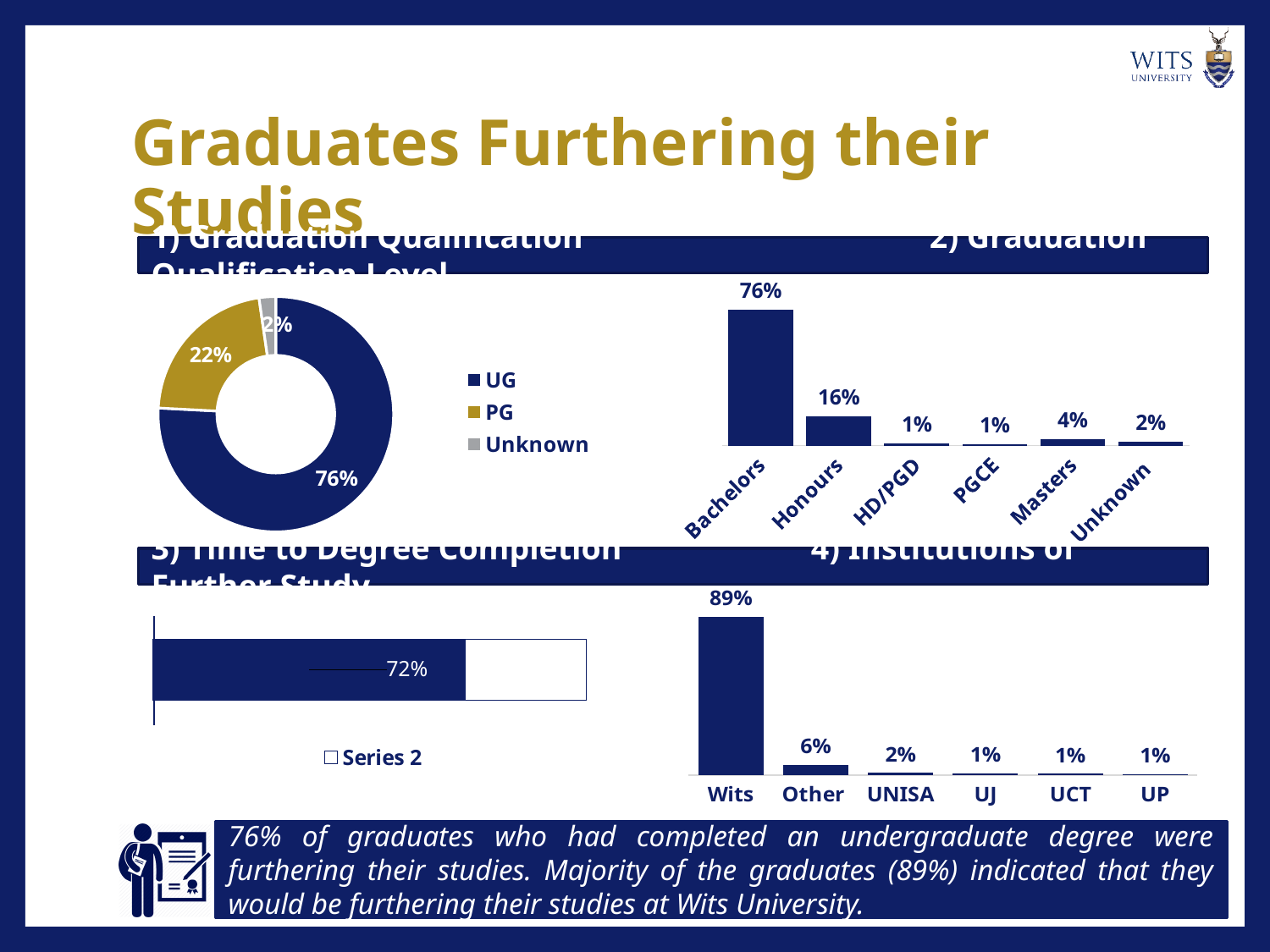
In the top-right bar chart, which category has the highest value? Bachelors In the top-right bar chart, what is the difference between the values for Bachelors and Honours? 60% How many categories are shown in the top-right bar chart? 6 How many entries does the legend of the top-left doughnut chart list? 3 What type of chart is the bottom-right chart? Bar chart In the bottom-right bar chart, what is the value for Wits? 89% In the bottom-right bar chart, which is larger, the value for Other or the value for UNISA? Other In the top-left doughnut chart, what percentage is shown for PG? 22% In the top-left doughnut chart, what percentage is shown for UG? 76% In the top-right bar chart, what is the value for Masters? 4% In the top-right bar chart, what is the value for Honours? 16% What value is labelled on the bar in the bottom-left chart? 72%